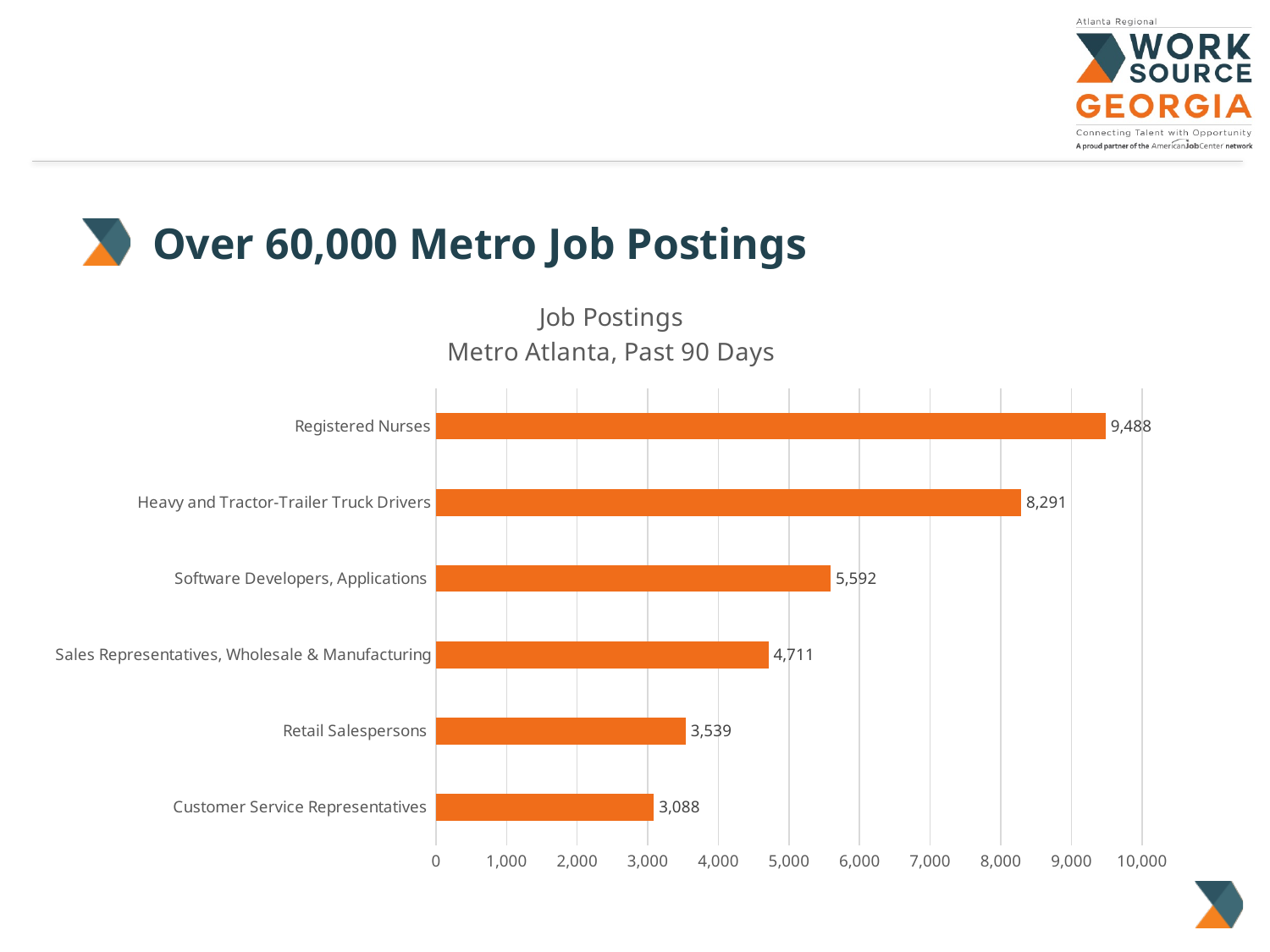
Is the value for Heavy and Tractor-Trailer Truck Drivers greater or less than 8,000? greater What is the difference in job postings between Registered Nurses and Heavy and Tractor-Trailer Truck Drivers? 1,197 How many occupations are shown in the chart? 6 What is the value for Software Developers, Applications? 5,592 How many job postings are shown for Registered Nurses? 9,488 What is the difference in job postings between Retail Salespersons and Customer Service Representatives? 451 Which occupation has the highest number of job postings? Registered Nurses What is the title of the chart? Job Postings Metro Atlanta, Past 90 Days Which occupation has the lowest number of job postings? Customer Service Representatives How many job postings are shown for Customer Service Representatives? 3,088 Which has more job postings, Software Developers, Applications or Sales Representatives, Wholesale & Manufacturing? Software Developers, Applications What kind of chart is shown on the slide? bar chart